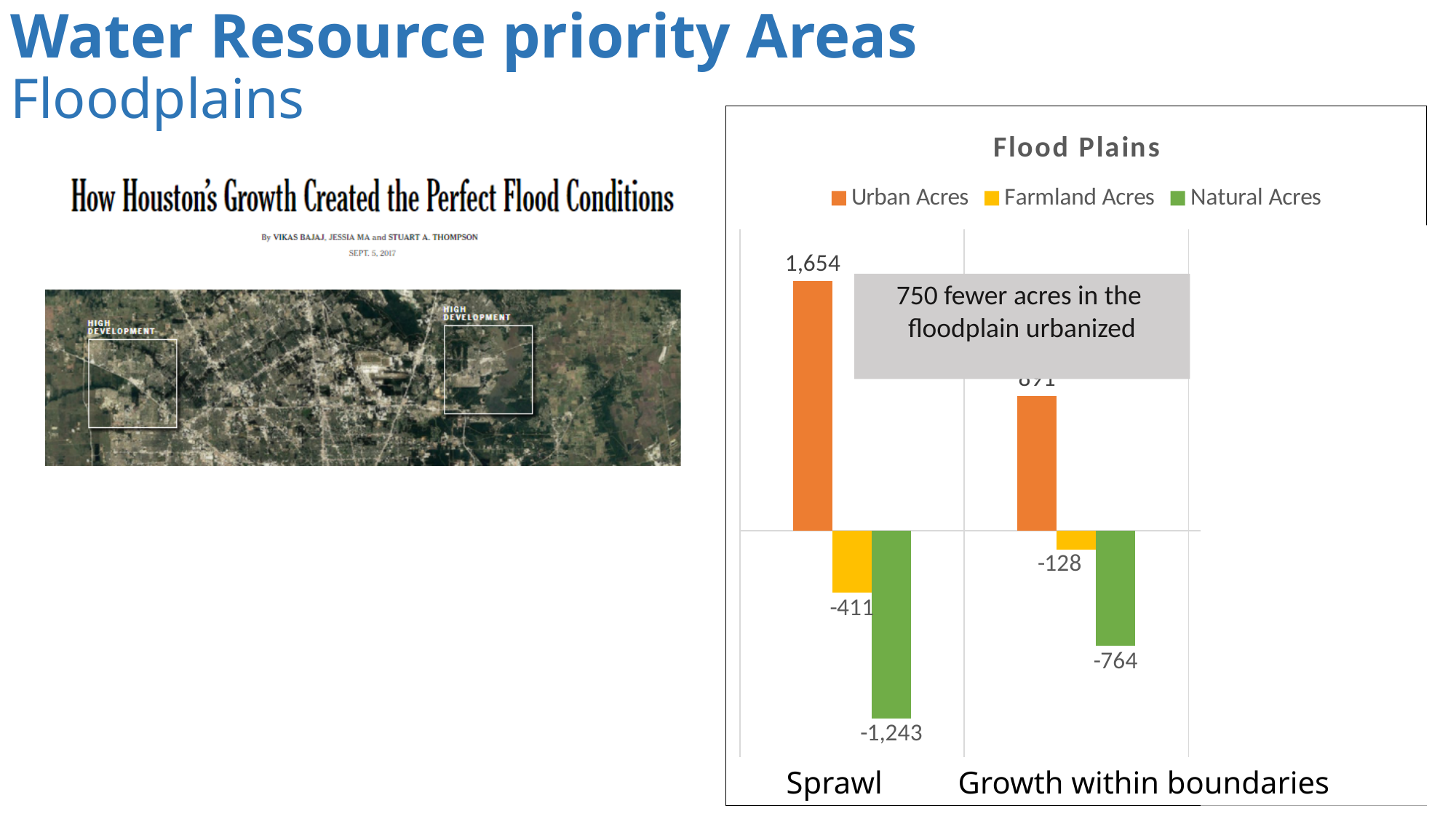
In the Flood Plains chart, is the Farmland Acres value larger for Sprawl or for Growth within boundaries? Growth within boundaries What is the value of Natural Acres for Growth within boundaries in the Flood Plains chart? -764 What colour are the Natural Acres bars in the Flood Plains chart? green What is the value of Farmland Acres for Growth within boundaries in the Flood Plains chart? -128 In the Flood Plains chart, which series has the lowest value for Sprawl? Natural Acres What is the value of Natural Acres for Sprawl in the Flood Plains chart? -1,243 What is the value of Farmland Acres for Sprawl in the Flood Plains chart? -411 What type of chart is shown under the title "Flood Plains"? bar chart What is the value of Urban Acres for Sprawl in the Flood Plains chart? 1,654 How many series does the legend of the Flood Plains chart list? 3 How many categories are shown on the x axis of the Flood Plains chart? 2 In the Flood Plains chart, what is the difference between the Natural Acres values for Sprawl and Growth within boundaries? 479